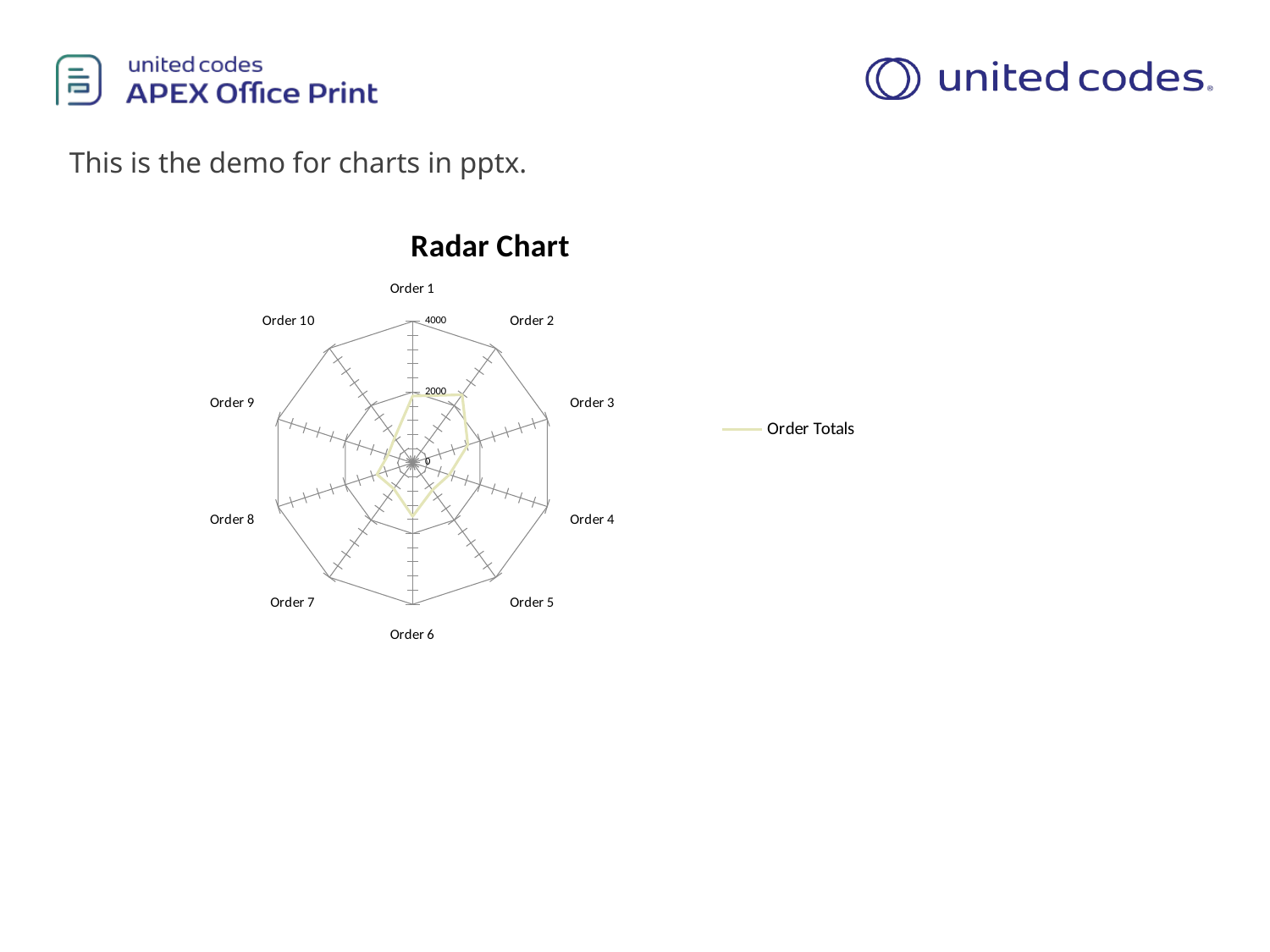
How many categories are plotted on the radar chart? 10 What series name appears in the legend of the radar chart? Order Totals Is the value for Order 1 greater or less than 4000? less What is the title of the chart on the slide? Radar Chart Which has the larger value, Order 6 or Order 4? Order 6 How many series does the legend of the radar chart list? 1 What kind of chart is shown on the slide? Radar chart Is the value for Order 6 greater or less than 4000? less Is the value for Order 5 greater or less than 2000? less Which has the larger value, Order 1 or Order 9? Order 1